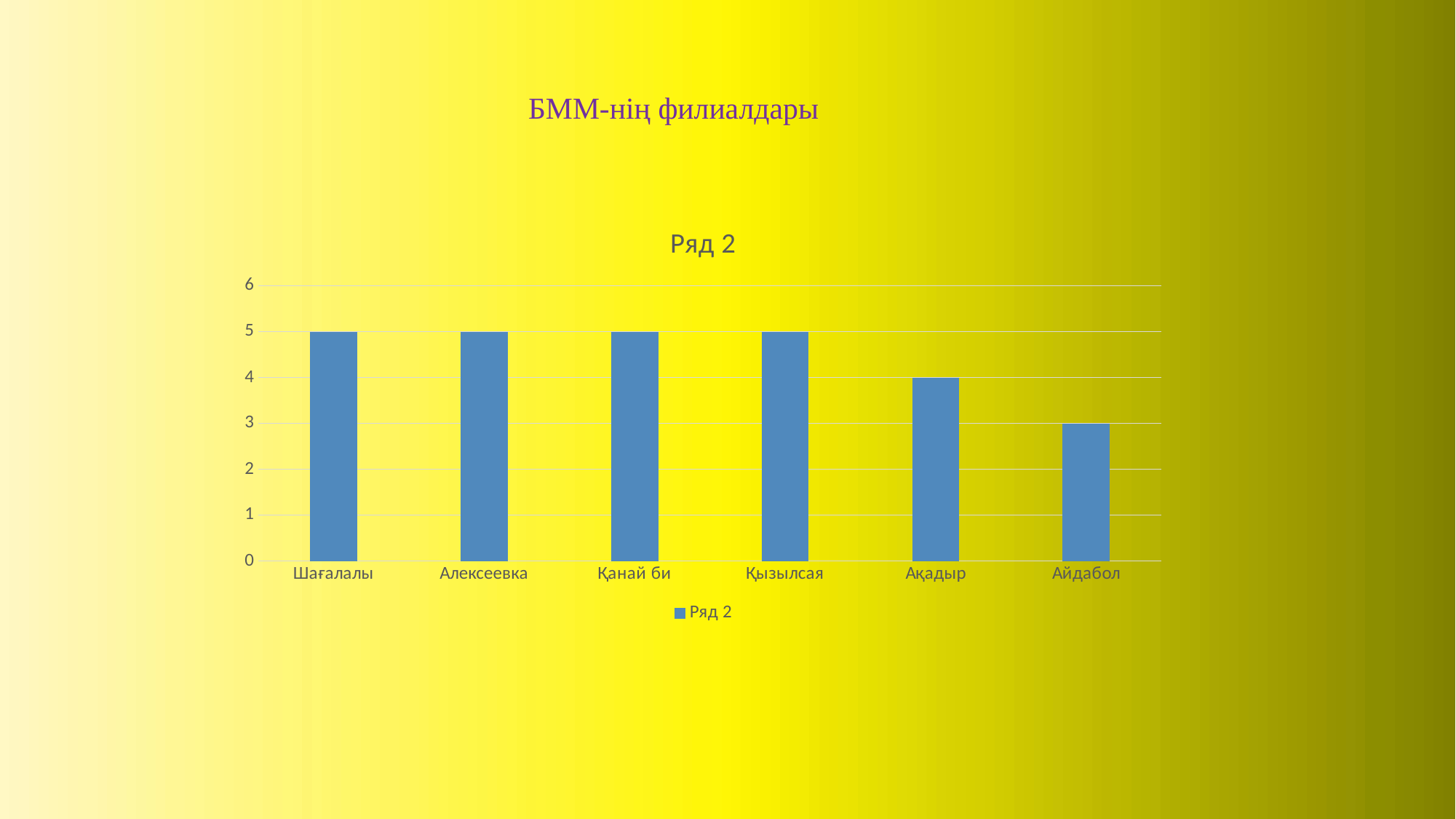
How many categories are shown on the x axis? 6 What is the difference between the values for Қанай би and Айдабол? 2 What is the difference between the values for Ақадыр and Айдабол? 1 What is the title of the chart? Ряд 2 How many series does the legend list? 1 What is the value for Шағалалы? 5 Which is larger, the value for Алексеевка or the value for Ақадыр? Алексеевка What is the value for Айдабол? 3 What is the value for Қызылсая? 5 What kind of chart is shown on the slide? bar chart What is the value for Ақадыр? 4 Which category has the lowest value? Айдабол